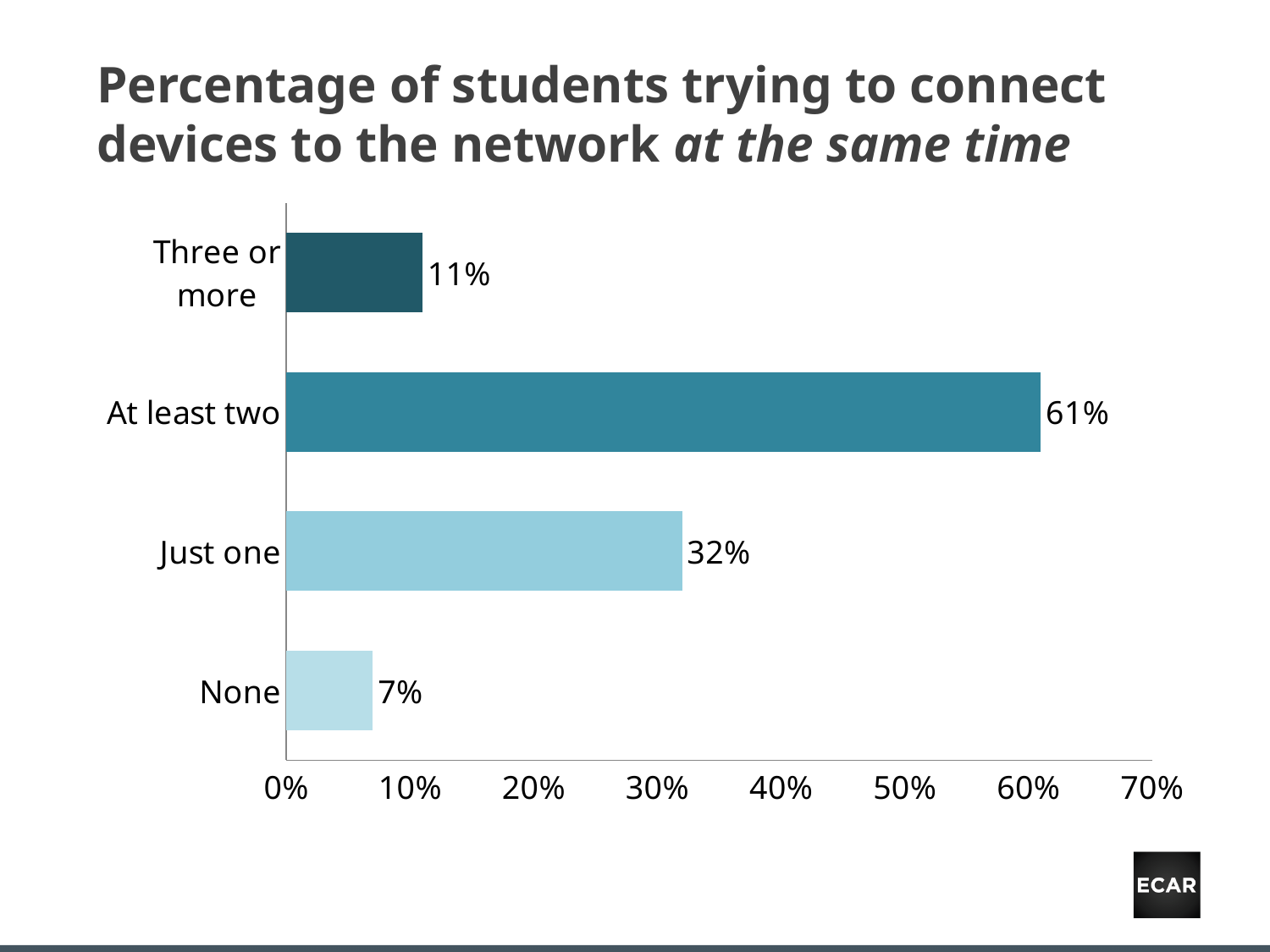
How many categories are shown in the chart? 4 What is the value for the 'Just one' category? 32% Which category has the highest percentage? At least two What kind of chart is shown on the slide? Bar chart What is the value shown for 'None'? 7% Which is larger, the value for 'Just one' or the value for 'Three or more'? Just one What percentage of students try to connect at least two devices to the network at the same time? 61% What is the maximum value shown on the horizontal axis? 70% What is the difference between the 'Three or more' and 'None' values? 4% What percentage of students connect three or more devices at the same time? 11% Which category has the lowest percentage? None What is the difference between the 'At least two' and 'Just one' values? 29%